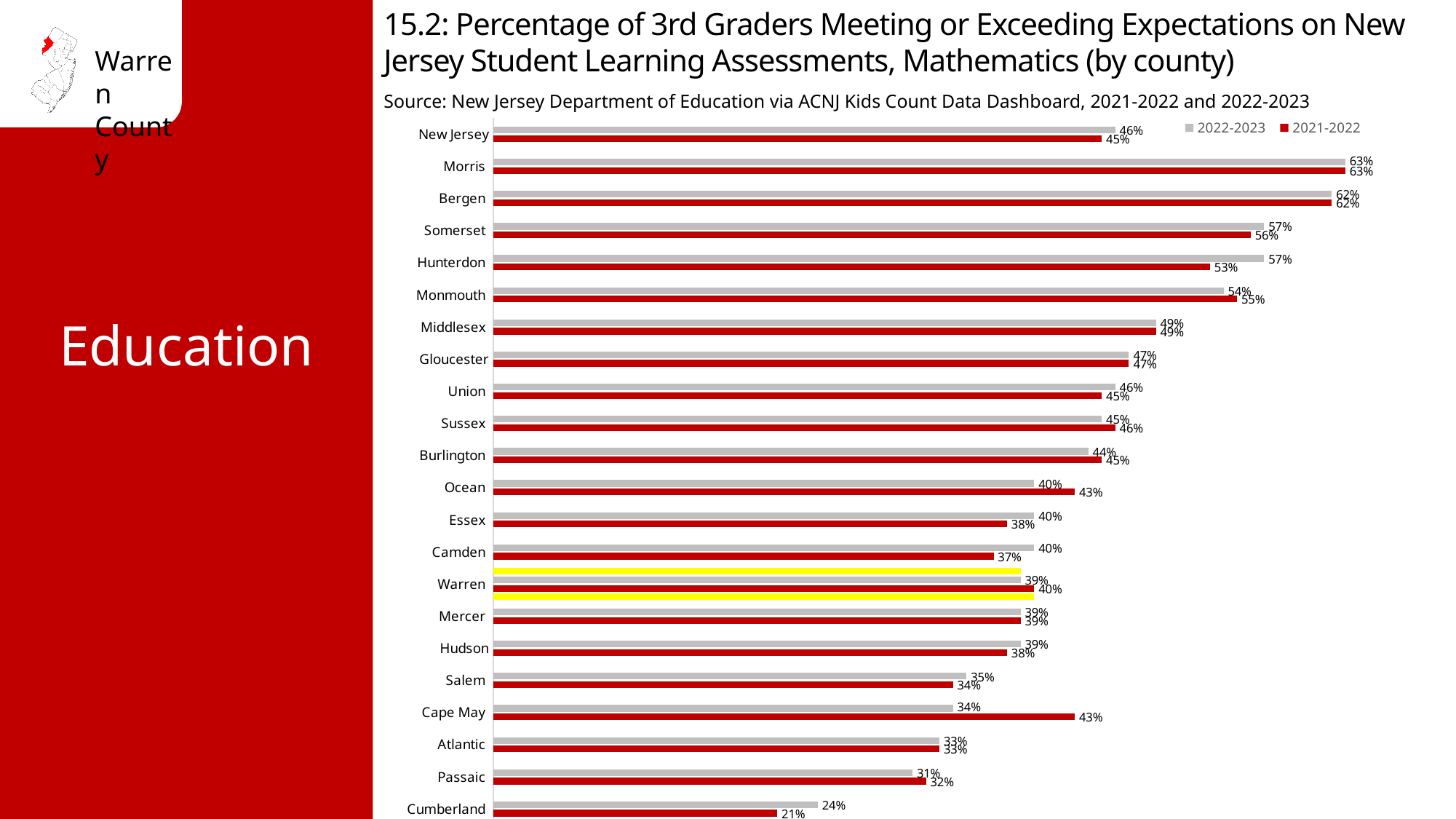
What is the 2022-2023 value for Hunterdon? 57% What is the 2022-2023 value for Warren? 39% What is the difference between the 2021-2022 and 2022-2023 values for Cape May? 9% Which county has the lowest 2021-2022 value? Cumberland What type of chart is shown on the slide? bar chart What is the 2021-2022 value for New Jersey? 45% What is the 2021-2022 value for Cape May? 43% Which county has the highest 2022-2023 value? Morris How many series does the legend list? 2 Which is larger for Ocean: the 2022-2023 value or the 2021-2022 value? 2021-2022 How many categories (counties plus New Jersey) are plotted on the chart? 22 Which county's bars are highlighted in yellow on the chart? Warren